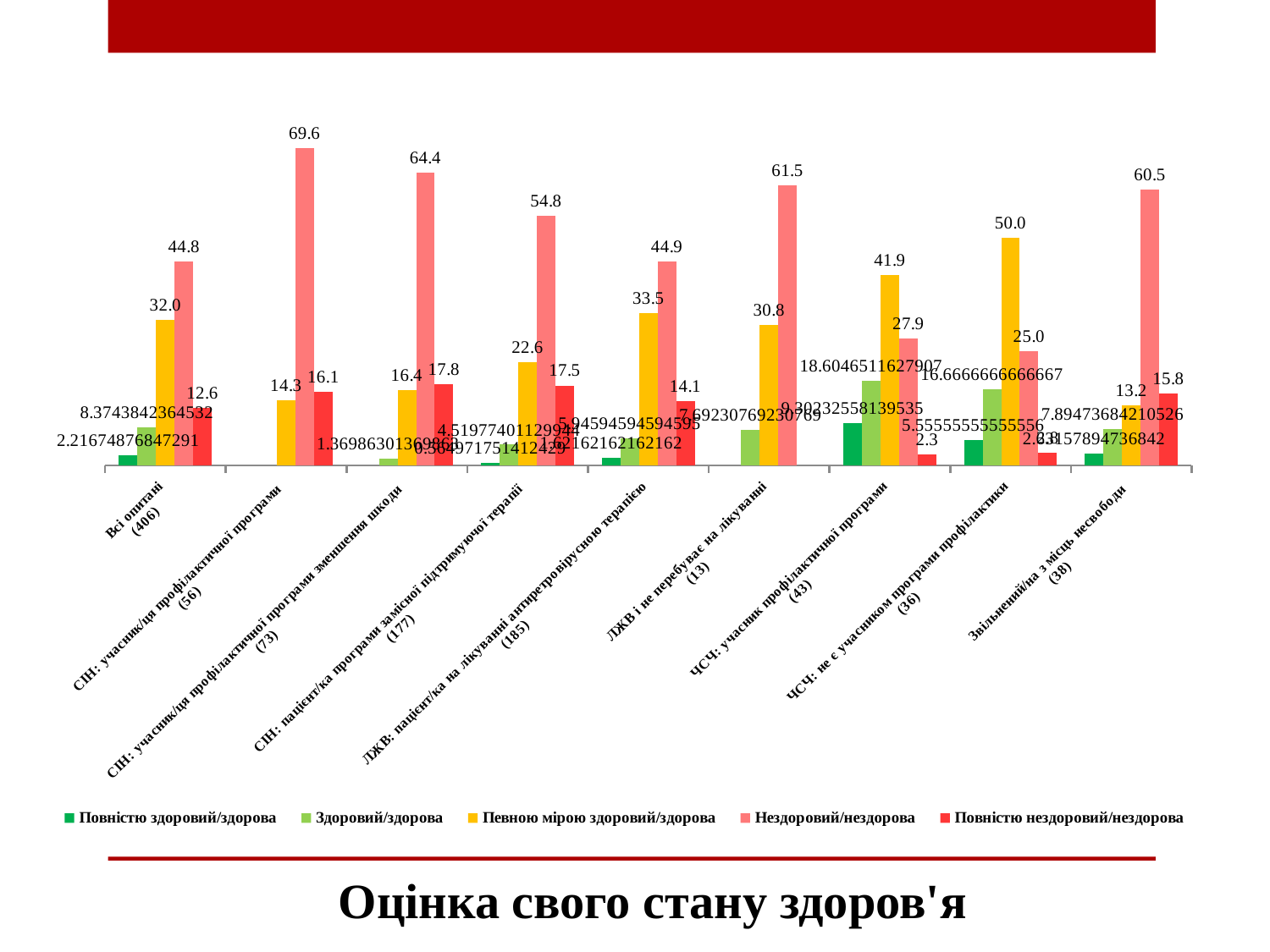
What type of chart is shown on the slide? bar chart What is the value of "Нездоровий/нездорова" for "ЛЖВ і не перебуває на лікуванні (13)"? 61.5 What is the title of the chart? Оцінка свого стану здоров'я Which category has the highest value for "Нездоровий/нездорова"? СІН: учасник/ця профілактичної програми (56) How many series does the legend list? 5 What is the value of "Нездоровий/нездорова" for "СІН: учасник/ця профілактичної програми (56)"? 69.6 How many categories are shown on the x axis? 9 What is the difference between "Нездоровий/нездорова" and "Певною мірою здоровий/здорова" for "Всі опитані (406)"? 12.8 Which is larger: "Нездоровий/нездорова" for "СІН: пацієнт/ка програми замісної підтримуючої терапії (177)" or for "ЛЖВ: пацієнт/ка на лікуванні антиретровірусною терапією (185)"? СІН: пацієнт/ка програми замісної підтримуючої терапії (177) What is the value of "Нездоровий/нездорова" for "Звільнений/на з місць несвободи (38)"? 60.5 What is the value of "Певною мірою здоровий/здорова" for "ЧСЧ: не є учасником програми профілактики (36)"? 50.0 What is the value of "Певною мірою здоровий/здорова" for "Всі опитані (406)"? 32.0